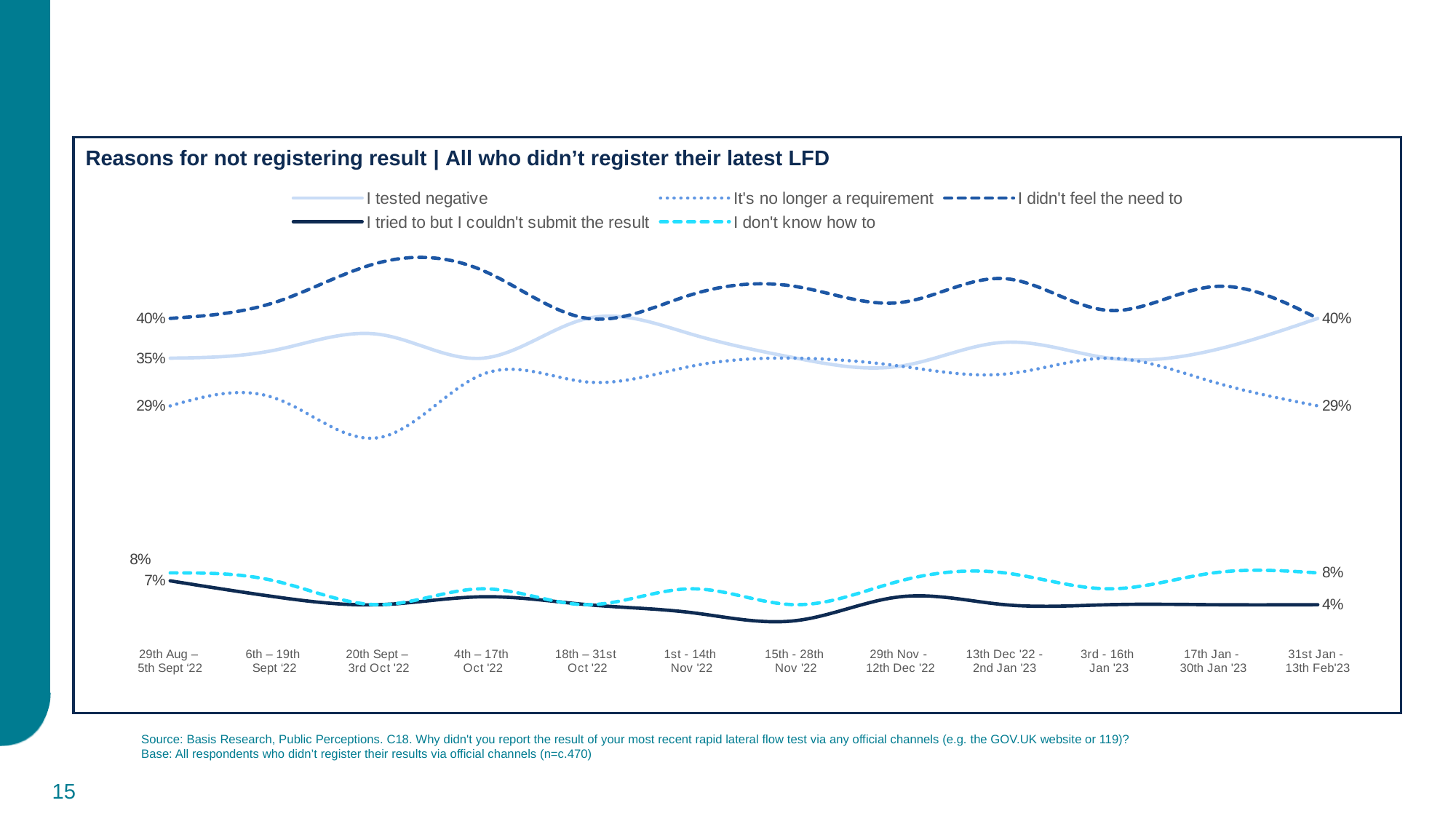
What is the value for 'I tried to but I couldn't submit the result' in the 31st Jan - 13th Feb '23 period? 4% What type of chart is shown on the slide? Line chart What is the title of the chart? Reasons for not registering result | All who didn't register their latest LFD What is the value for 'I didn't feel the need to' in the 29th Aug – 5th Sept '22 period? 40% Which reason has the lowest value in the 31st Jan - 13th Feb '23 period? I tried to but I couldn't submit the result What is the value for 'It's no longer a requirement' in the 29th Aug – 5th Sept '22 period? 29% What is the value for 'I tried to but I couldn't submit the result' in the 29th Aug – 5th Sept '22 period? 7% What is the value for 'I tested negative' in the 29th Aug – 5th Sept '22 period? 35% How many time periods are shown along the x axis? 12 How many series does the legend list? 5 What is the value for 'It's no longer a requirement' in the 31st Jan - 13th Feb '23 period? 29% By how many percentage points did 'I tried to but I couldn't submit the result' fall from the 29th Aug – 5th Sept '22 period to the 31st Jan - 13th Feb '23 period? 3 percentage points